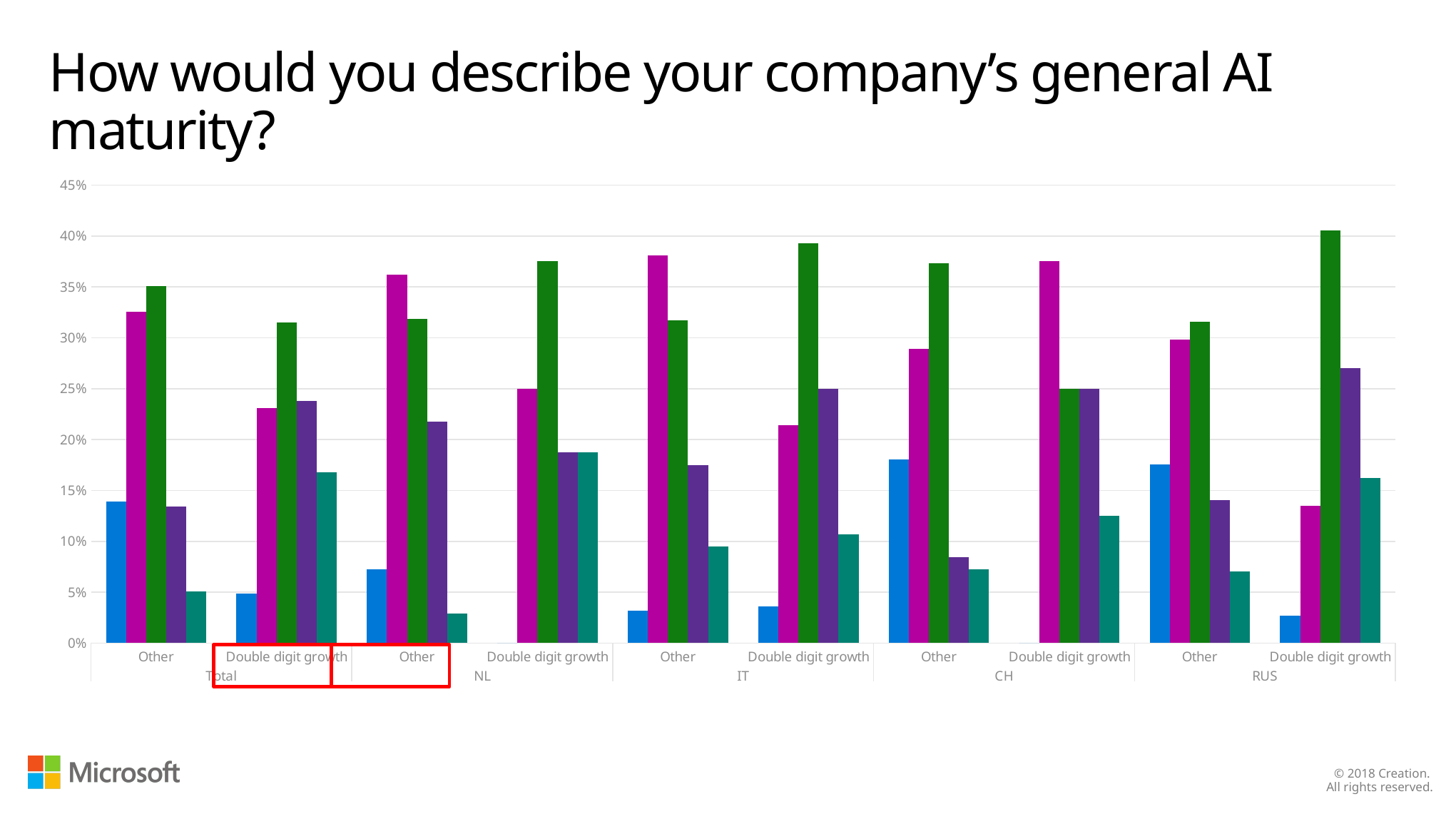
What is the highest value shown on the y axis? 45% Is the green bar for RUS "Double digit growth" greater or less than 35%? greater In the NL "Other" group, which is taller: the magenta bar or the green bar? the magenta bar Is the magenta bar for IT "Other" greater or less than 35%? greater What is the title of the chart? How would you describe your company's general AI maturity? How many bars are plotted in the Total "Other" group? 5 How many country/region groups are labelled along the x axis (Total, NL, IT, CH, RUS)? 5 In the RUS "Double digit growth" group, which is taller: the magenta bar or the green bar? the green bar What kind of chart is shown on the slide? bar chart Is the blue bar for CH "Other" greater or less than 15%? greater